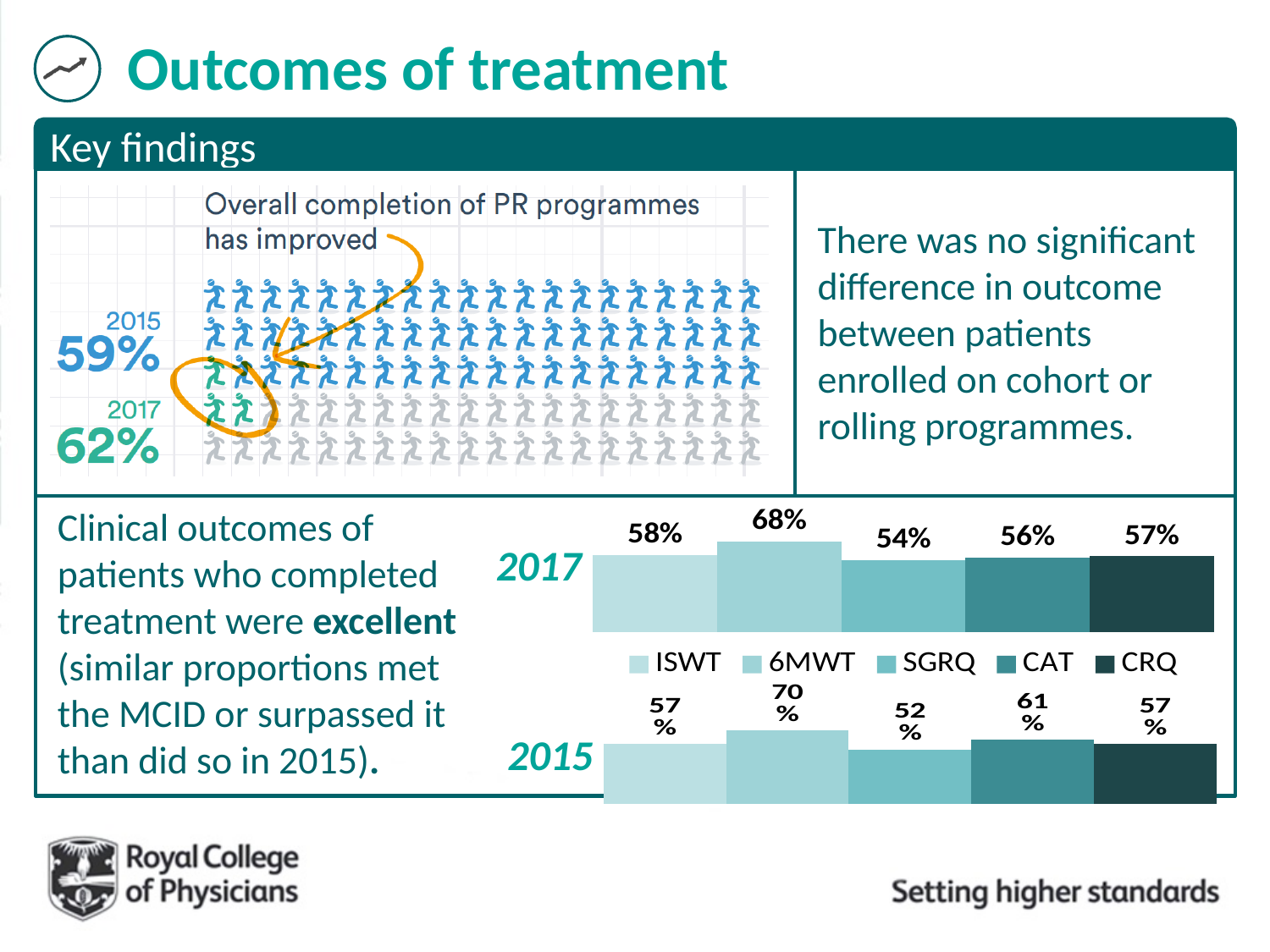
How many measures are shown in the legend of the bar charts? 5 In the 2015 bar chart, what is the value for CAT? 61% In the 2017 bar chart, which measure has the lowest value? SGRQ In the 2017 bar chart, what is the difference between the 6MWT and SGRQ values? 14% What is the difference between the 6MWT value in 2015 and the 6MWT value in 2017? 2% In the 2015 bar chart, which measure has the highest value? 6MWT In the 2017 bar chart, what is the value for SGRQ? 54% What kind of chart is used to show the 2017 and 2015 clinical outcomes? Bar chart In the 2017 bar chart, what is the value for 6MWT? 68% In the pictogram at the top of the slide, what was the overall completion rate of PR programmes in 2017? 62% Which is larger: the CAT value in 2015 or the CAT value in 2017? 2015 In the 2015 bar chart, which measure has the lowest value? SGRQ